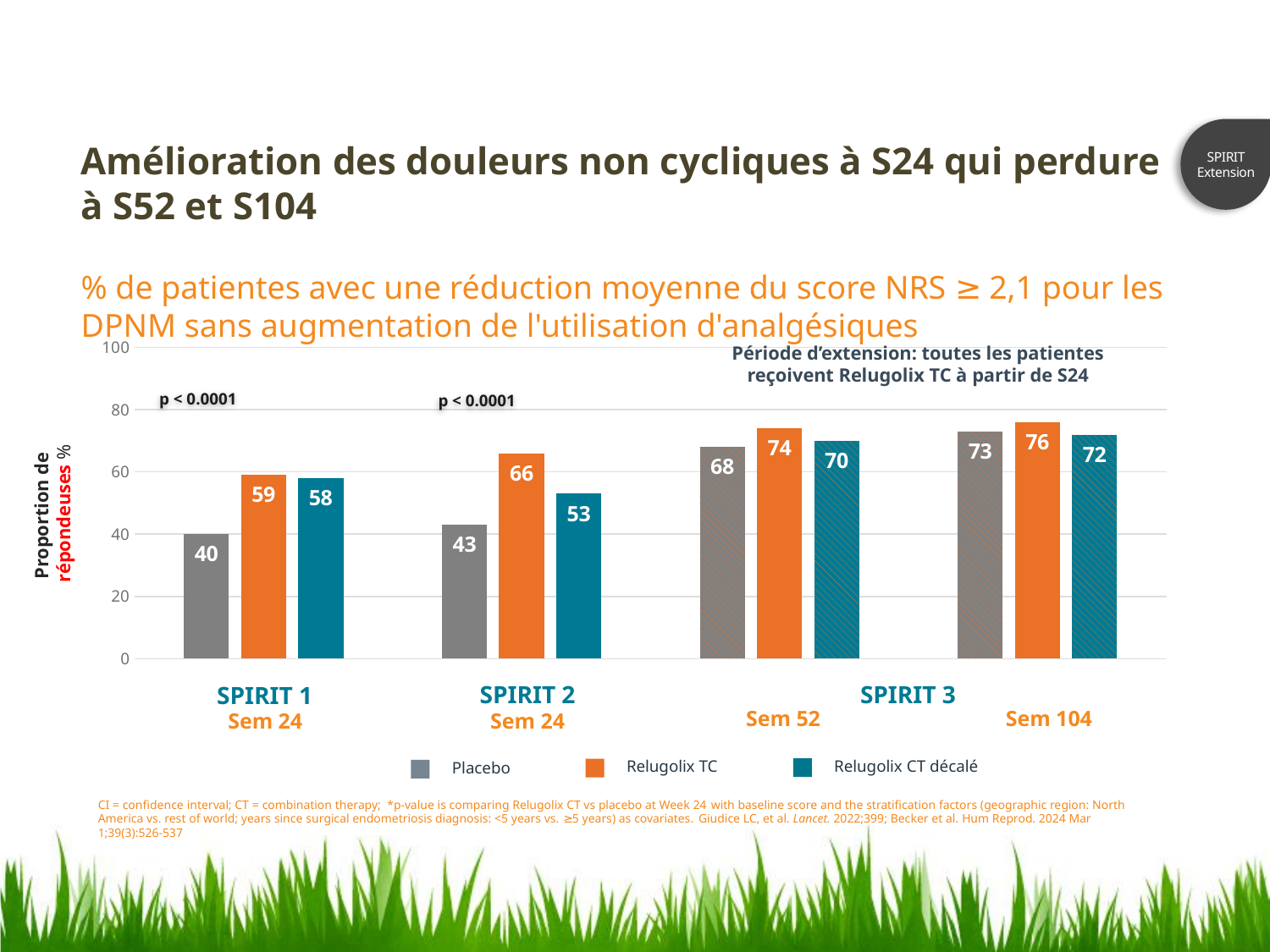
Is the Placebo value in the SPIRIT 3 Sem 52 group greater or less than 60? greater Which group has the lowest Placebo value? SPIRIT 1 Sem 24 Do the Placebo values rise or fall from SPIRIT 1 Sem 24 to SPIRIT 3 Sem 104? Rise How many series does the legend list? 3 In the SPIRIT 1 Sem 24 group, which is larger: the Relugolix TC value or the Relugolix CT décalé value? Relugolix TC What kind of chart is shown on the slide? Bar chart What is the value for Relugolix CT décalé in the SPIRIT 3 Sem 104 group? 72 What is the value for Placebo in the SPIRIT 1 Sem 24 group? 40 How many groups of bars are shown on the x axis? 4 Which group has the highest Relugolix TC value? SPIRIT 3 Sem 104 What is the difference between the Relugolix TC and Placebo values in the SPIRIT 2 Sem 24 group? 23 What is the value for Relugolix TC in the SPIRIT 2 Sem 24 group? 66